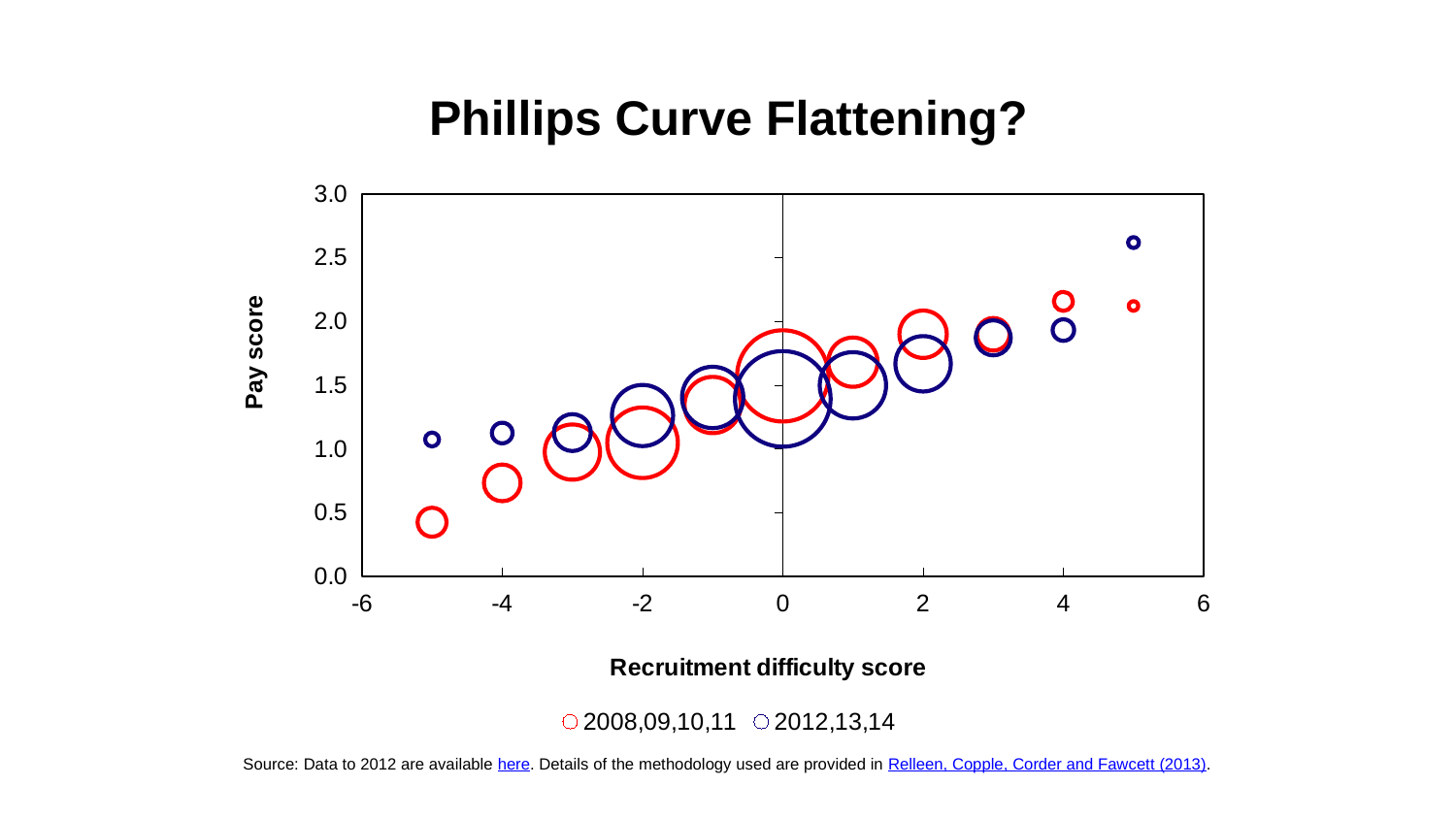
As the recruitment difficulty score increases, does the pay score generally rise or fall? rise Is the pay score for the 2012,13,14 series at a recruitment difficulty score of -5 greater or less than 0.5? greater What is the label of the horizontal axis? Recruitment difficulty score Which series contains the bubble with the lowest pay score on the chart? 2008,09,10,11 How many bubbles are plotted for the 2008,09,10,11 series? 11 At a recruitment difficulty score of 5, which series has the higher pay score? 2012,13,14 At a recruitment difficulty score of -4, which series has the higher pay score? 2012,13,14 What kind of chart is shown on the slide? bubble chart What is the title of the chart? Phillips Curve Flattening? How many series does the legend list? 2 Is the pay score for the 2012,13,14 series at a recruitment difficulty score of 5 greater or less than 2.0? greater Is the pay score for the 2008,09,10,11 series at a recruitment difficulty score of -5 greater or less than 1.0? less